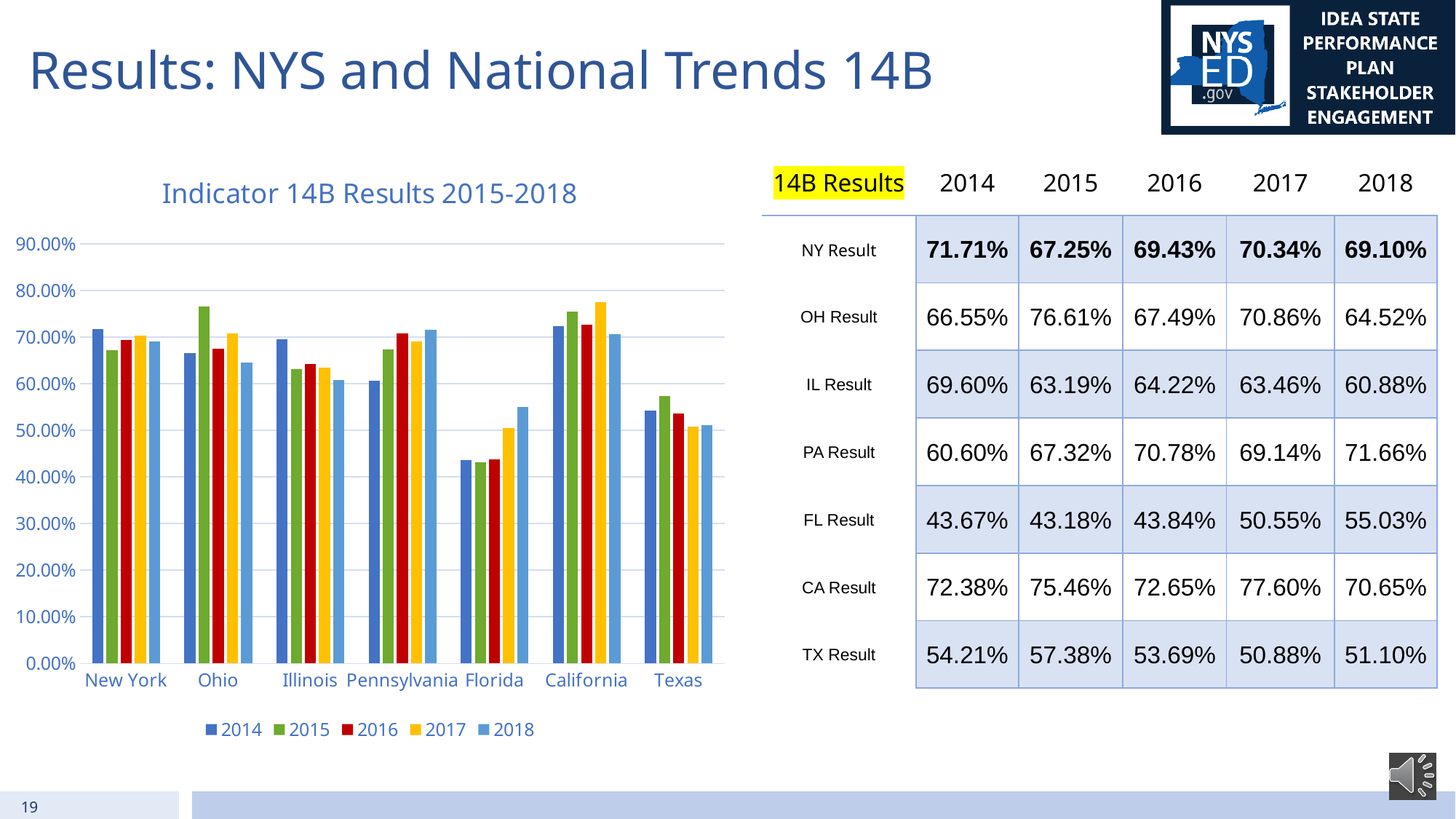
Is the 2014 value for Florida greater or less than 50.00%? less How many series does the chart legend list? 5 What is the 2014 result for New York? 71.71% What is the difference between California's and New York's 2017 results? 7.26% Which state has the lowest 2015 result? Florida What is the title of the chart? Indicator 14B Results 2015-2018 Which state has the highest 2017 result? California Which is larger, Ohio's 2015 result or Illinois's 2015 result? Ohio's 2015 result What kind of chart is shown on the slide? bar chart What is the 2018 result for Florida? 55.03% Do Florida's results generally rise or fall from 2014 to 2018? rise How many states are shown along the x axis of the chart? 7